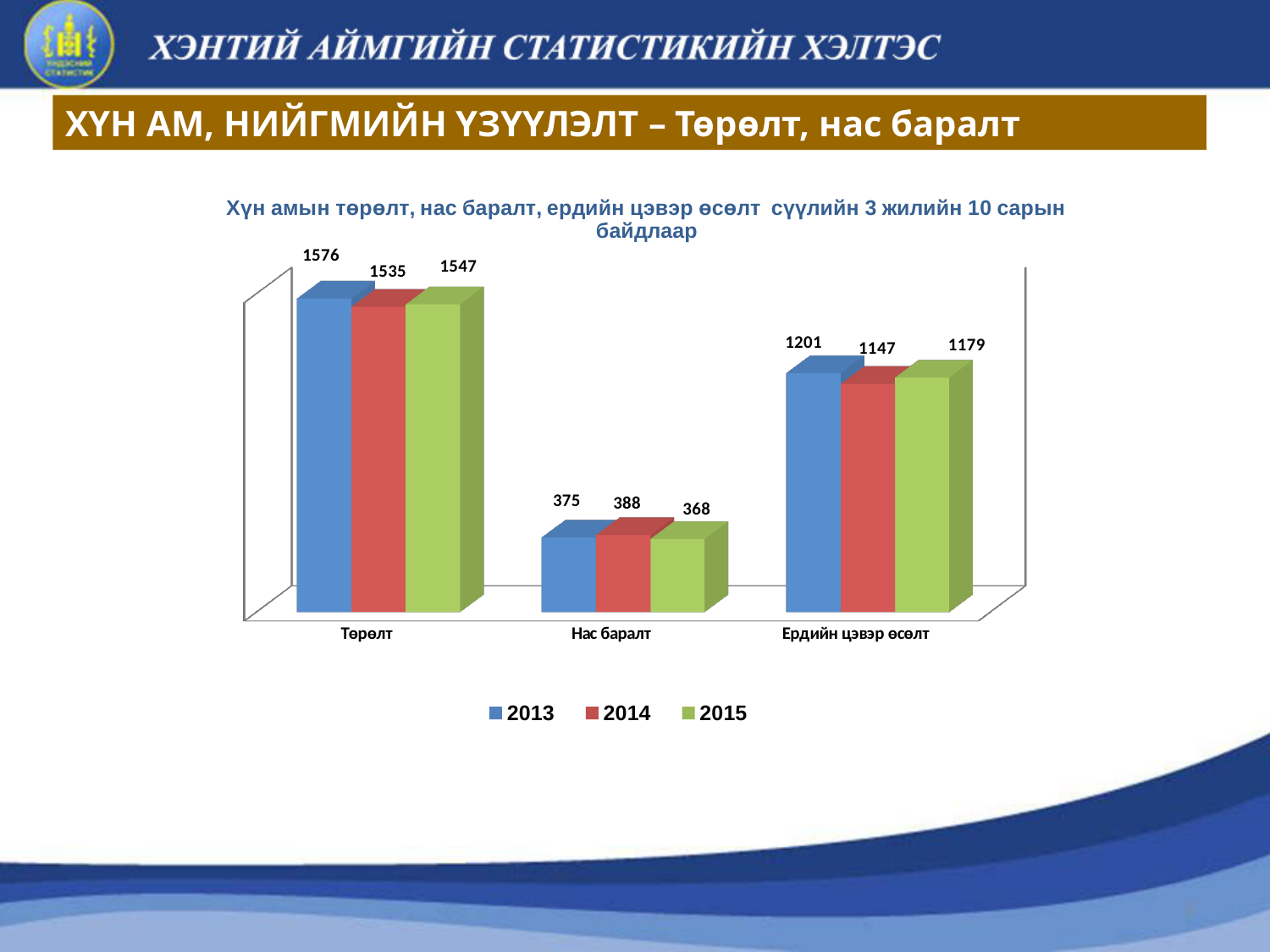
What is the difference between the 2013 and 2014 values for Төрөлт? 41 What is the difference between the 2013 and 2015 values for Ердийн цэвэр өсөлт? 22 What kind of chart is shown on the slide? Bar chart How many categories are shown on the x axis? 3 What is the value for Ердийн цэвэр өсөлт in 2015? 1179 Which category has the lowest value in 2015? Нас баралт Which colour represents the 2014 series in the legend? Red Which year has the highest value for Төрөлт? 2013 How many series does the legend list? 3 Which is larger: Нас баралт in 2014 or Нас баралт in 2015? Нас баралт in 2014 What is the value for Төрөлт in 2013? 1576 What is the value for Нас баралт in 2014? 388